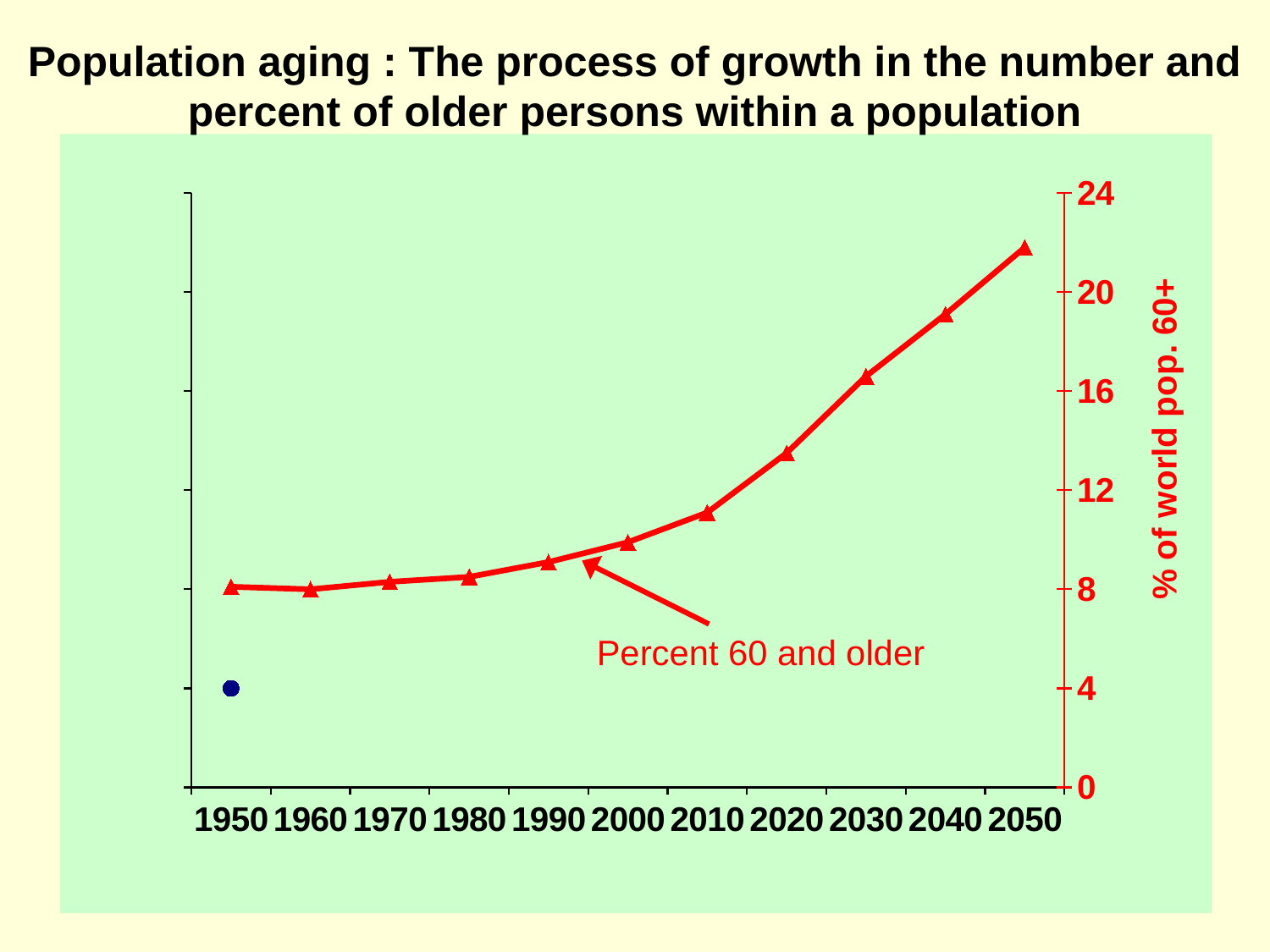
What kind of chart is shown on the slide? line chart Which is larger, the value for Percent 60 and older in 2020 or in 2040? 2040 How many data points are plotted on the Percent 60 and older line? 11 Is the value for Percent 60 and older in 2000 greater or less than 8? greater What label is attached to the red line by the arrow? Percent 60 and older Is the value for Percent 60 and older in 2010 greater or less than 12? less What is the label on the right-hand vertical axis? % of world pop. 60+ Is the value for Percent 60 and older in 2050 greater or less than 20? greater Does the Percent 60 and older line rise or fall from 1950 to 2050? rise Which year has the highest value for Percent 60 and older? 2050